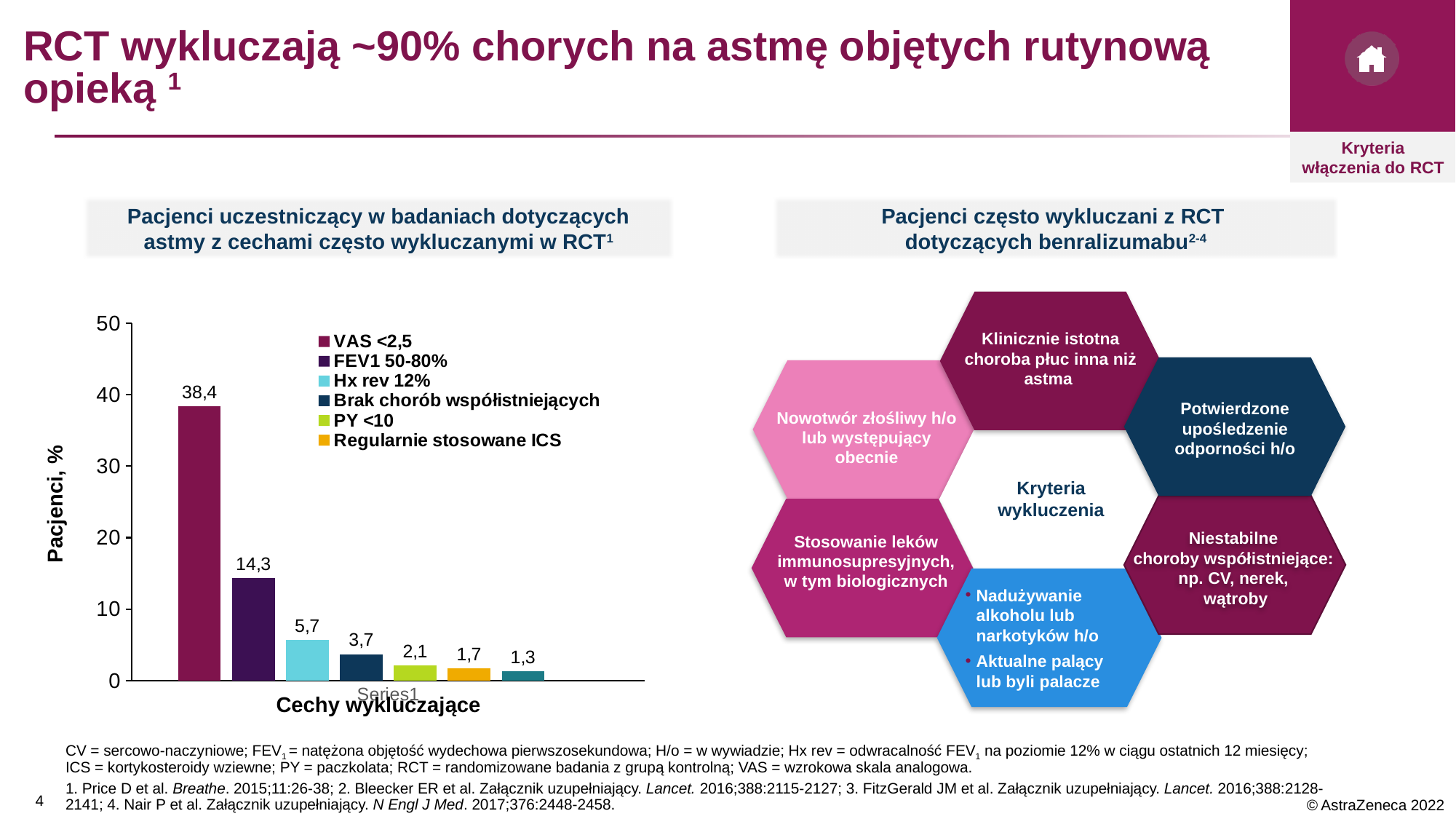
How many bars are plotted in the chart? 7 What is the value for VAS <2,5 in the bar chart? 38,4 What is the value for Hx rev 12% in the bar chart? 5,7 Which is larger: the value for Hx rev 12% or for Brak chorób współistniejących? Hx rev 12% What is the difference between the values for VAS <2,5 and FEV1 50-80%? 24,1 How many entries does the legend of the bar chart list? 6 What percentage of patients is shown for FEV1 50-80%? 14,3 Which legend category has the highest value in the bar chart? VAS <2,5 What kind of chart is shown on the left of the slide? Bar chart What is the value for PY <10 in the bar chart? 2,1 What is the value for Regularnie stosowane ICS? 1,7 What is the value for Brak chorób współistniejących? 3,7